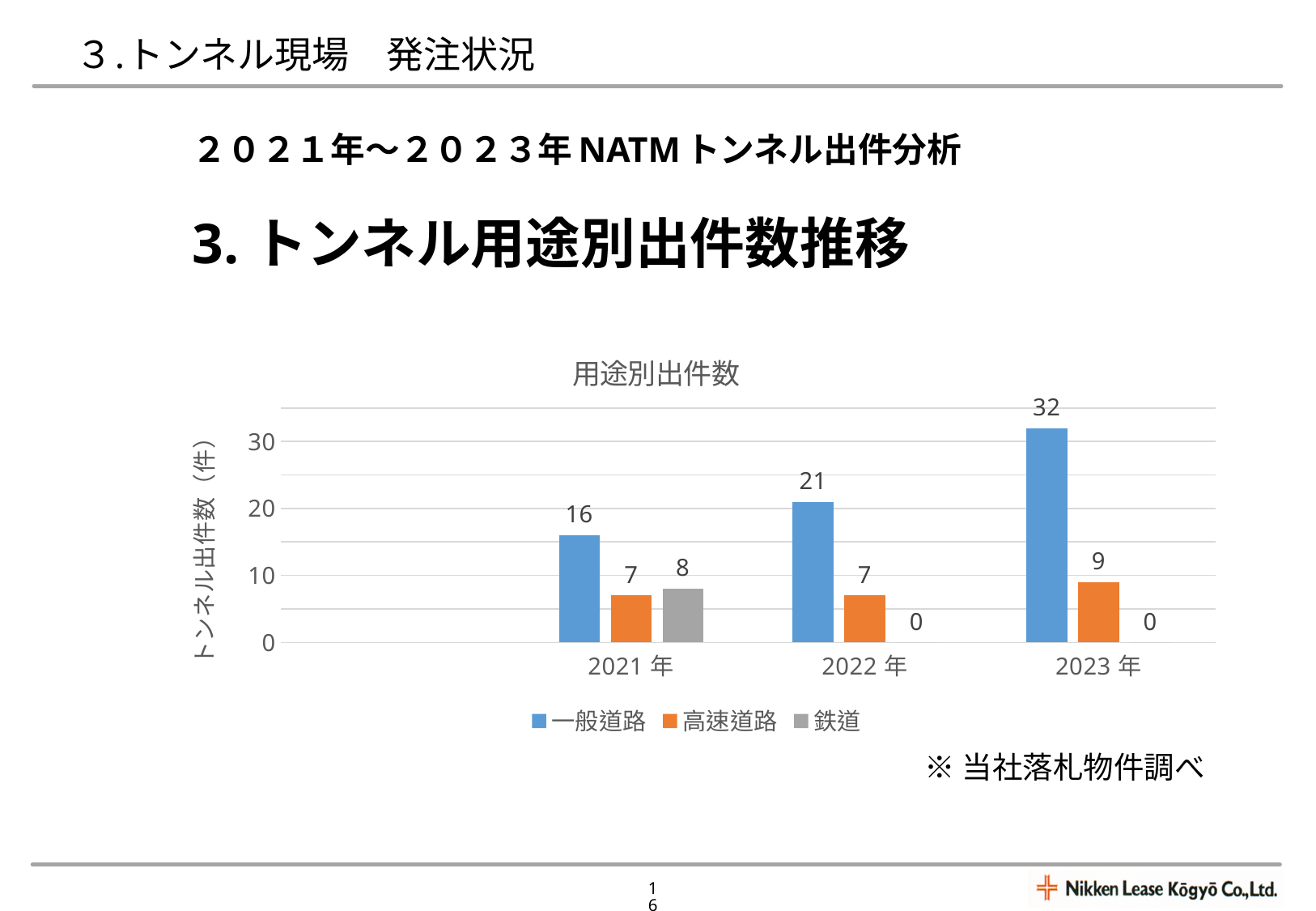
What is the value for 一般道路 in 2022年? 21 How many series does the legend list? 3 What is the value for 鉄道 in 2021年? 8 Does the value for 一般道路 rise or fall from 2021年 to 2023年? rise Is the value for 一般道路 in 2023年 greater or less than 30? greater Which year has the highest value for 一般道路? 2023年 Which year has the lowest value for 一般道路? 2021年 What is the value for 高速道路 in 2023年? 9 Which is larger in 2021年: 高速道路 or 鉄道? 鉄道 How many years are shown on the x axis? 3 What is the difference between the 一般道路 values for 2023年 and 2021年? 16 What kind of chart is shown? bar chart